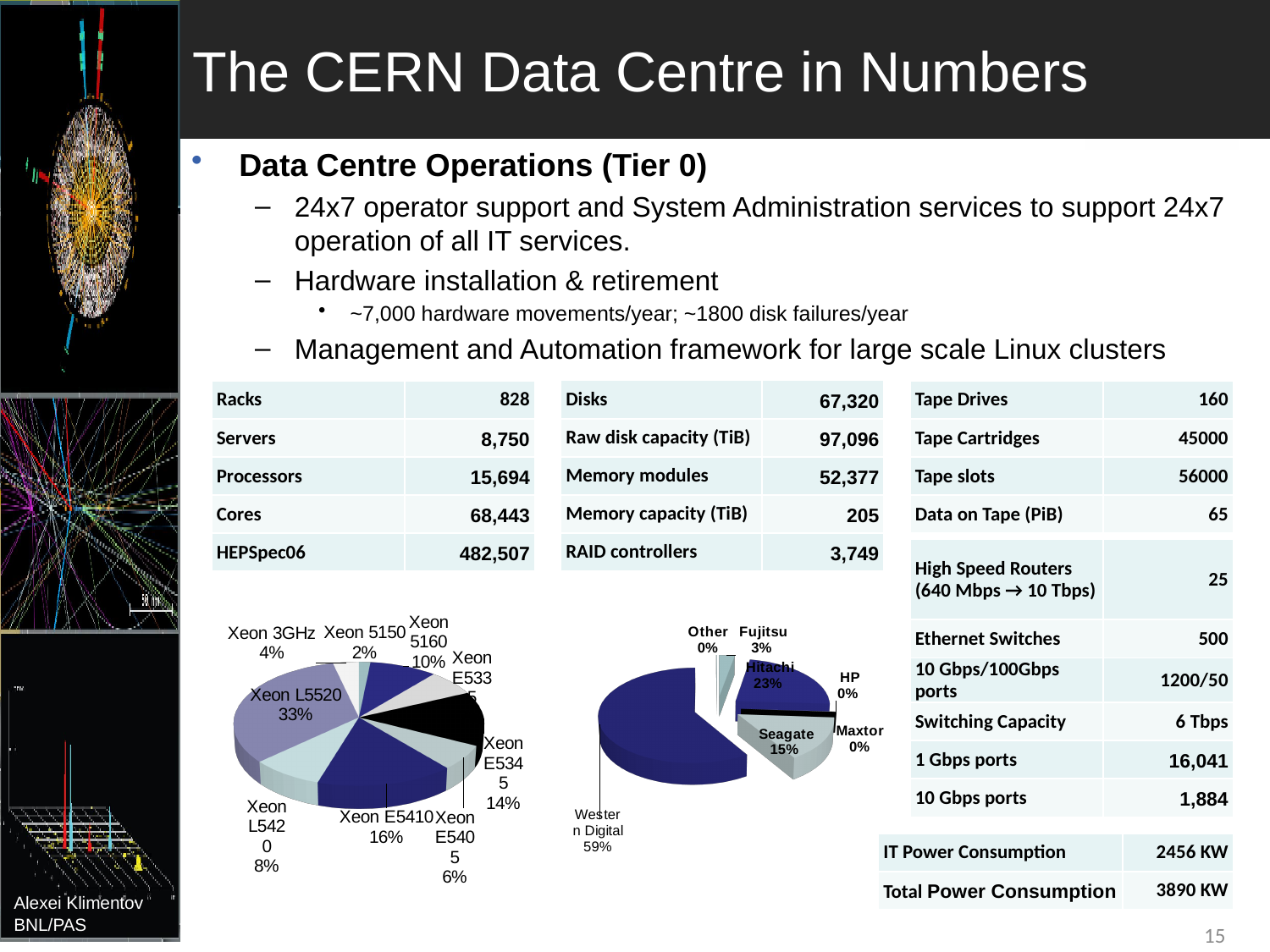
In the pie chart on the left, which is larger: Xeon E5345 or Xeon 5160? Xeon E5345 In the pie chart on the right, what is the difference between the shares of Hitachi and Seagate? 8% In the pie chart on the left, what is the difference between the shares of Xeon L5520 and Xeon E5410? 17% In the pie chart on the left, what share does Xeon E5410 have? 16% In the pie chart on the right, which manufacturer has the largest share? Western Digital In the pie chart on the left, which category has the smallest share? Xeon 5150 How many categories are shown in the pie chart on the right? 7 In the pie chart on the left, which category has the largest share? Xeon L5520 What kind of chart is the chart on the left? Pie chart In the pie chart on the right, what share does Western Digital have? 59% In the pie chart on the right, what share does Hitachi have? 23%